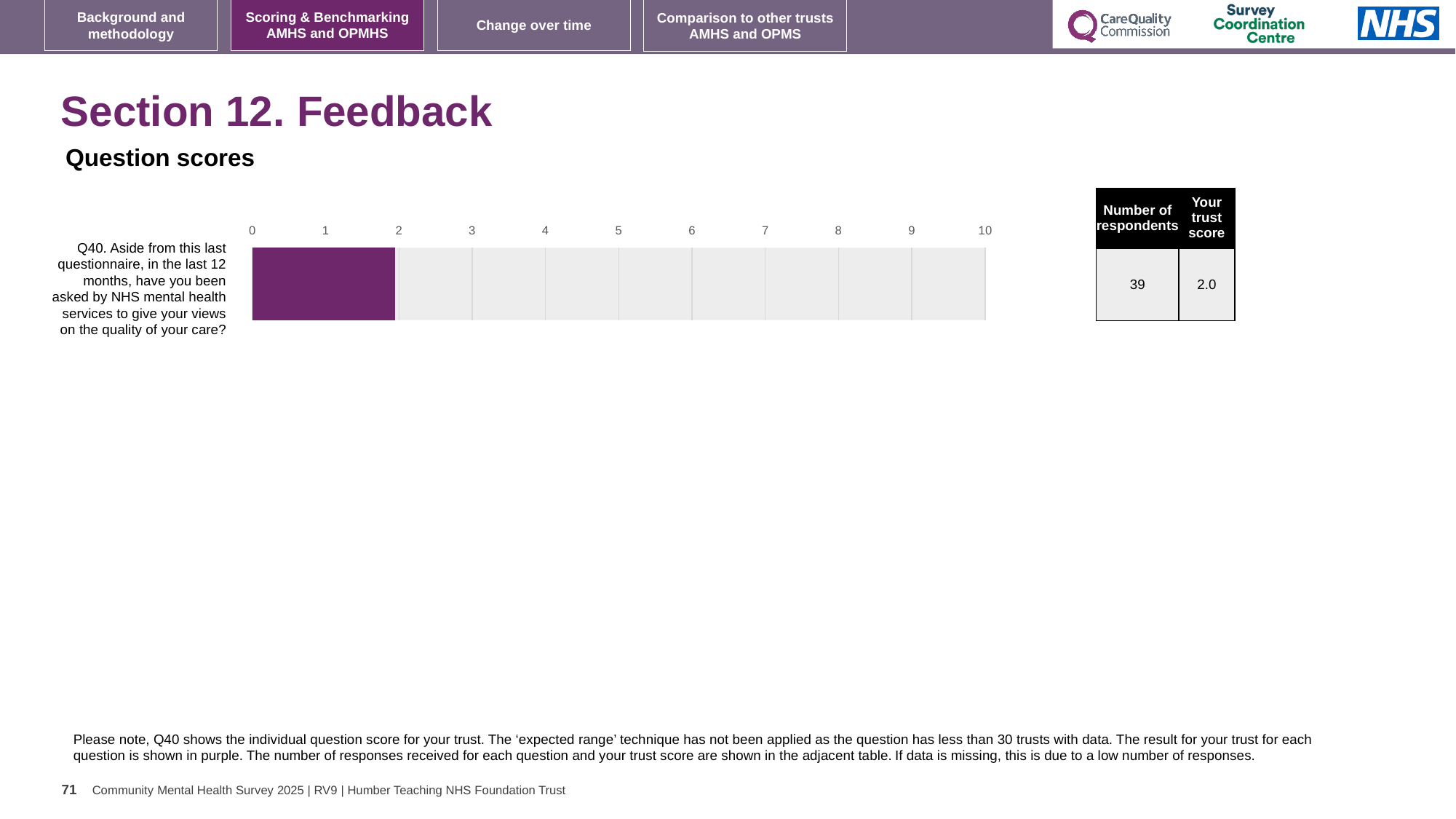
How many questions (categories) are plotted in the chart? 1 What is the trust score for Q40 shown in the chart? 2.0 What kind of chart is shown on the slide? Bar chart What colour is the bar representing the trust's score for Q40? Purple Is the value for Q40 greater or less than 5? less Is the value for Q40 greater or less than 1? greater What is the maximum value shown on the chart's axis? 10 How many respondents answered Q40 according to the table next to the chart? 39